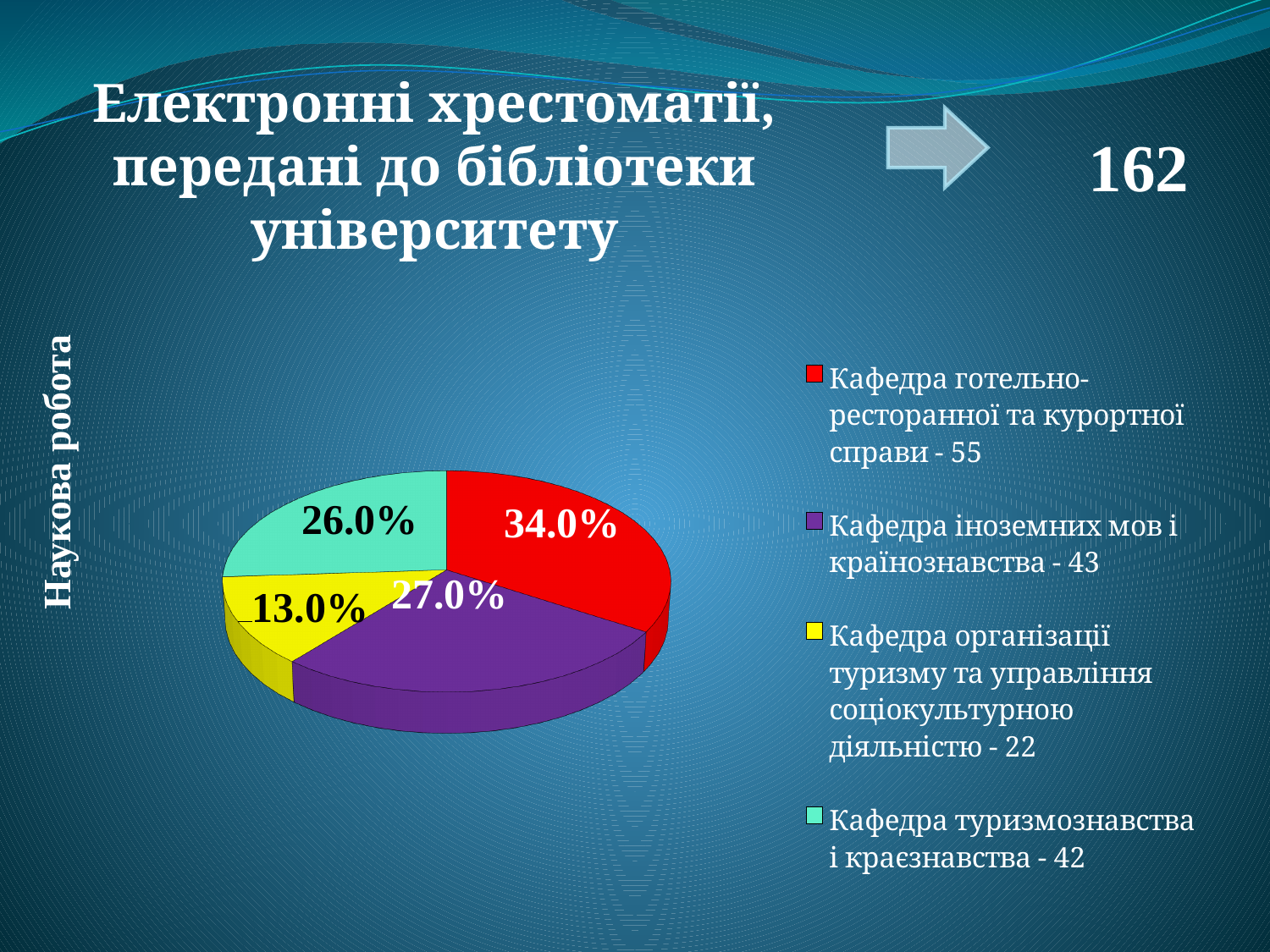
What number is shown next to the arrow at the top right of the slide? 162 Which department has the largest slice of the pie? Кафедра готельно-ресторанної та курортної справи What percentage share does the slice for Кафедра організації туризму та управління соціокультурною діяльністю have? 13.0% What percentage share does the slice for Кафедра готельно-ресторанної та курортної справи have? 34.0% What is the difference in percentage points between the largest slice (34.0%) and the smallest slice (13.0%)? 21.0% What colour is the slice for Кафедра туризмознавства і краєзнавства? light green (teal) How many slices does the pie chart have? 4 Which slice is larger: Кафедра іноземних мов і країнознавства or Кафедра туризмознавства і краєзнавства? Кафедра іноземних мов і країнознавства What percentage share does the slice for Кафедра іноземних мов і країнознавства have? 27.0% What kind of chart is shown on the slide? pie chart Which department has the smallest slice of the pie? Кафедра організації туризму та управління соціокультурною діяльністю